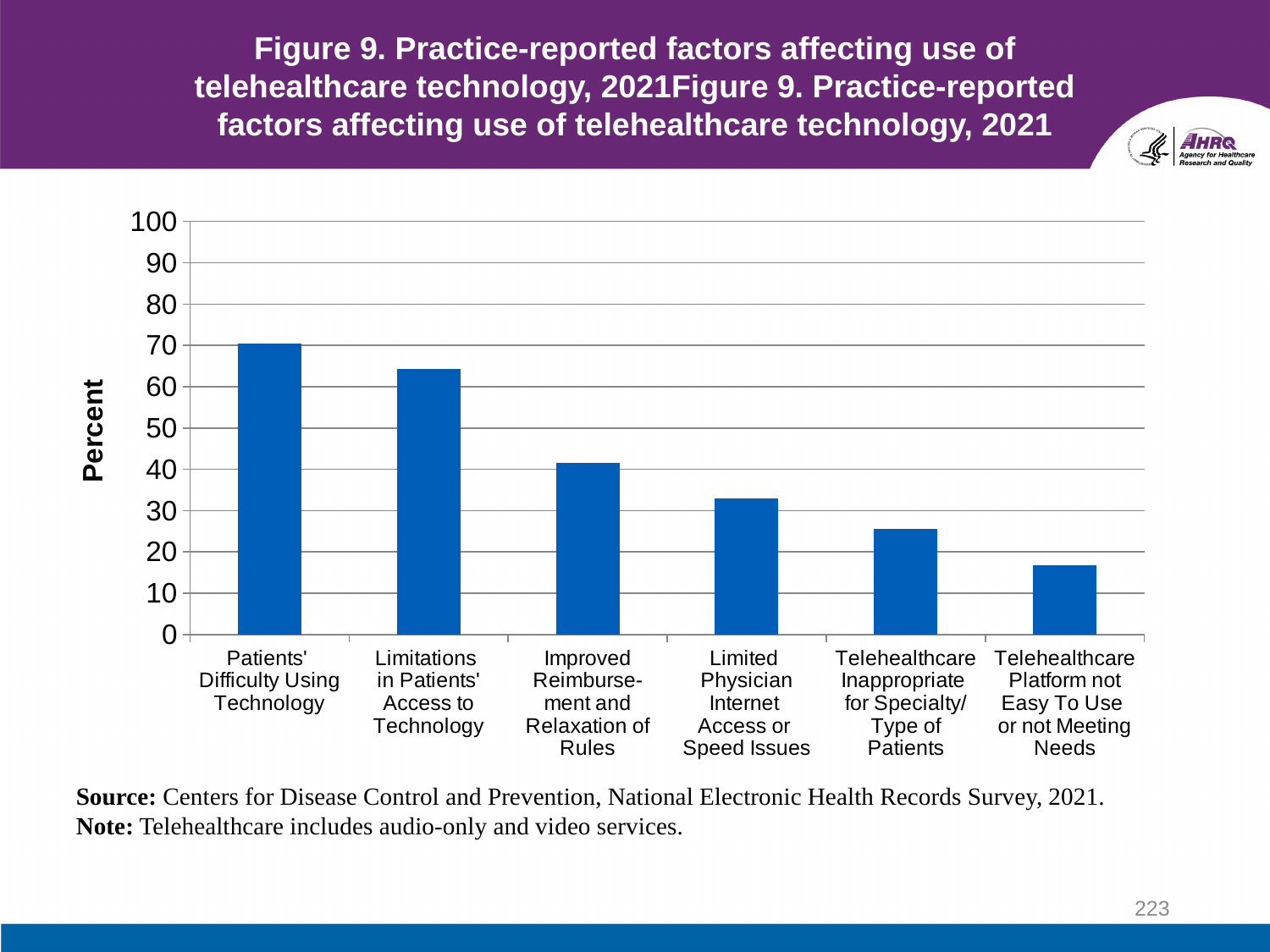
What is the label on the vertical axis of the chart? Percent Is the value for Improved Reimbursement and Relaxation of Rules greater or less than 50? less Is the value for Limitations in Patients' Access to Technology greater or less than 70? less Which factor has the highest percentage? Patients' Difficulty Using Technology Is the value for Limited Physician Internet Access or Speed Issues greater or less than 30? greater What kind of chart is shown on the slide? bar chart Do the bar values rise or fall from left to right across the chart? fall Which is larger: the value for Limited Physician Internet Access or Speed Issues or the value for Telehealthcare Platform not Easy To Use or not Meeting Needs? Limited Physician Internet Access or Speed Issues Which factor has the lowest percentage? Telehealthcare Platform not Easy To Use or not Meeting Needs How many factors (bars) are plotted in the chart? 6